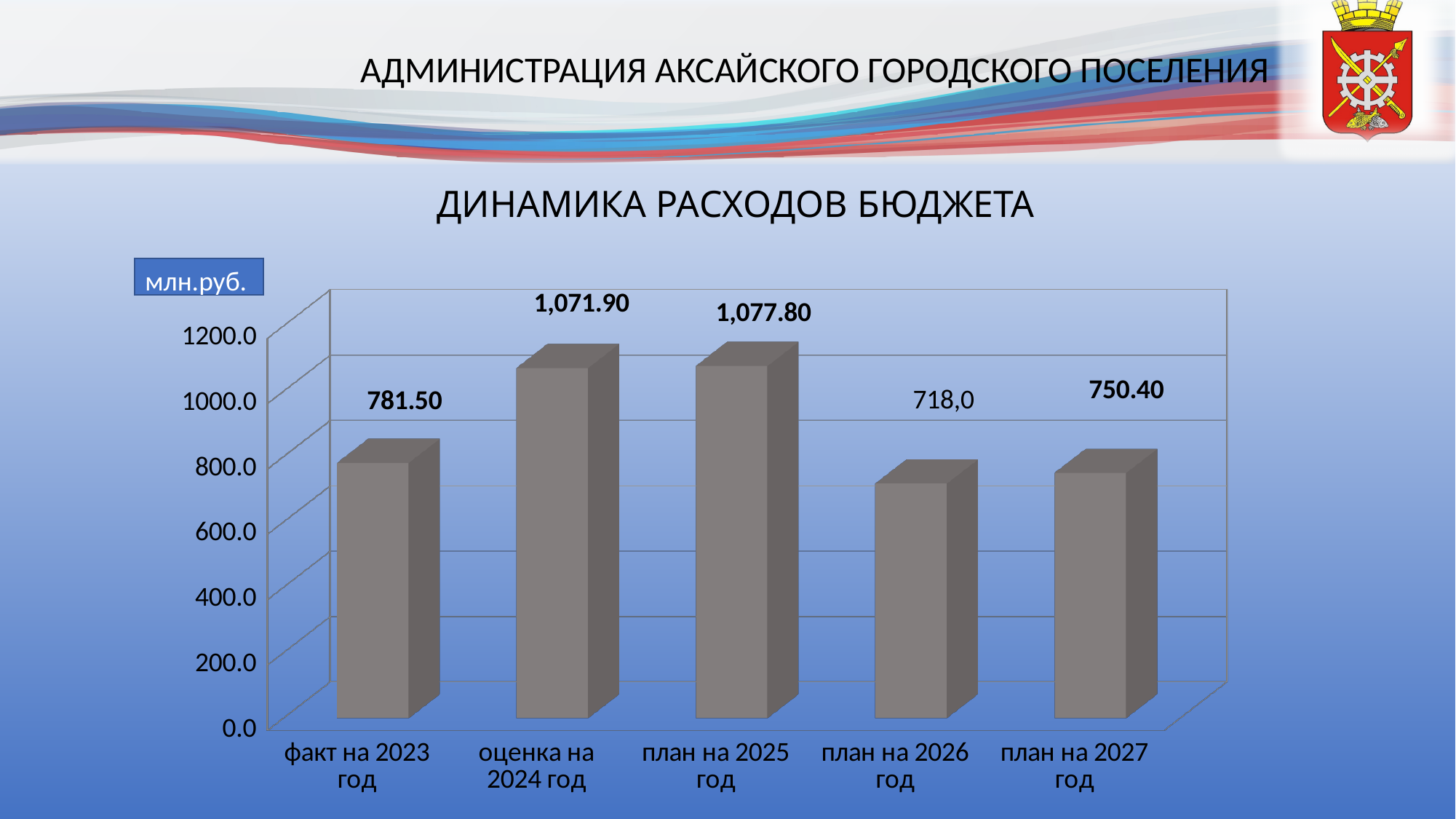
What is the value for "оценка на 2024 год"? 1,071.90 What is the difference between the values for "план на 2025 год" and "оценка на 2024 год"? 5.90 What is the difference between the values for "факт на 2023 год" and "план на 2027 год"? 31.10 What is the value for "план на 2027 год"? 750.40 What is the value for "план на 2025 год"? 1,077.80 How many categories are shown on the x axis? 5 Which category has the highest value? план на 2025 год What type of chart is shown on the slide? bar chart What is the value for "план на 2026 год"? 718,0 What unit of measurement is indicated for the chart? млн.руб. What is the value for "факт на 2023 год"? 781.50 Which category has the lowest value? план на 2026 год